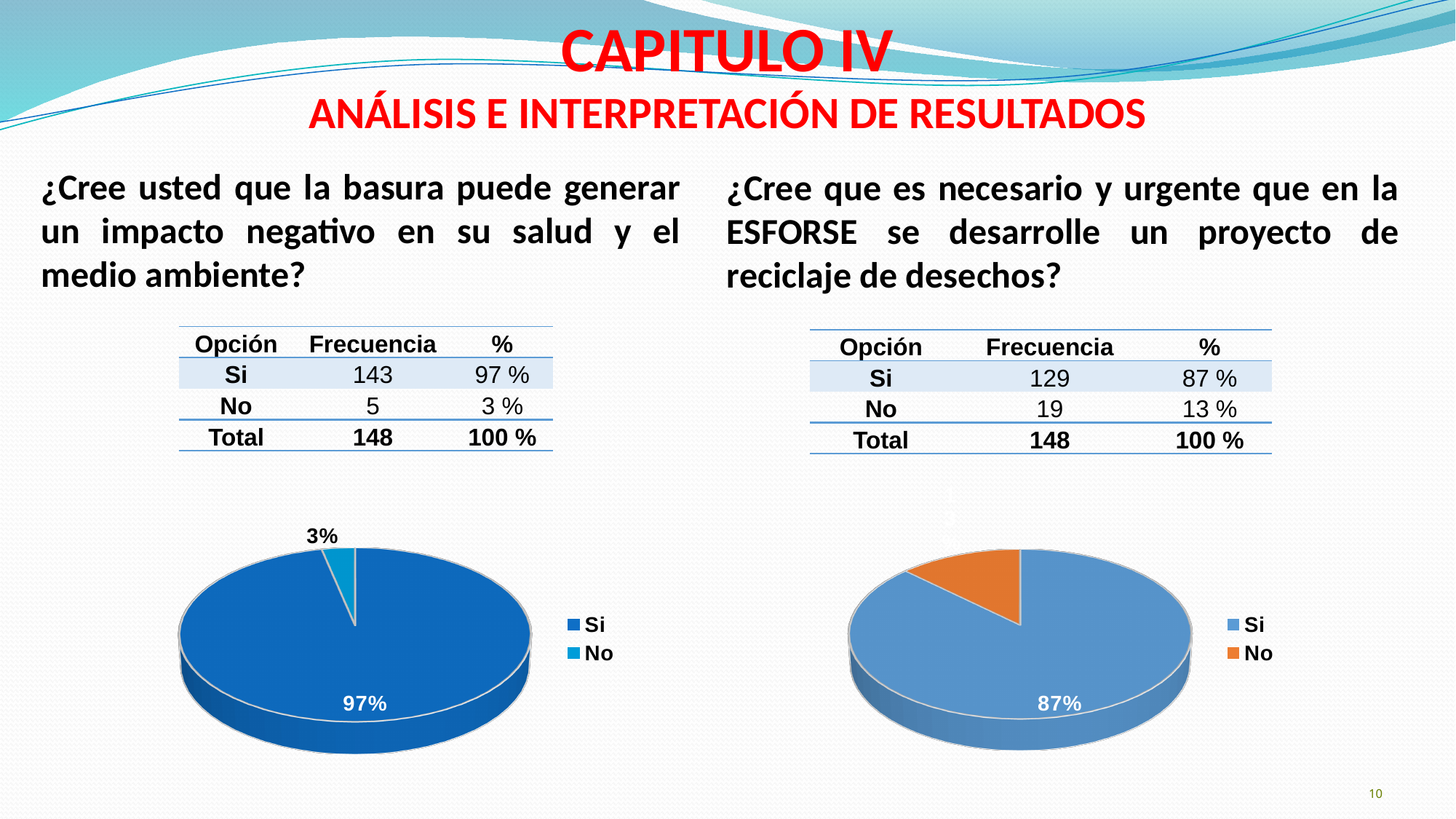
In the left pie chart, which slice is the largest? Si How many slices does the left pie chart have? 2 In the left pie chart, what percentage is shown for the No slice? 3% What kind of chart is shown on the left side of the slide? pie chart In the right pie chart, what percentage is shown for the Si slice? 87% Which is larger in the right pie chart, the Si slice or the No slice? Si In the right pie chart, which slice is the smallest? No What kind of chart is shown on the right side of the slide? pie chart How many entries does the legend of the right pie chart list? 2 In the right pie chart, what colour is the No slice? orange In the left pie chart, what is the difference in percentage points between the Si and No slices? 94 In the left pie chart, what percentage is shown for the Si slice? 97%